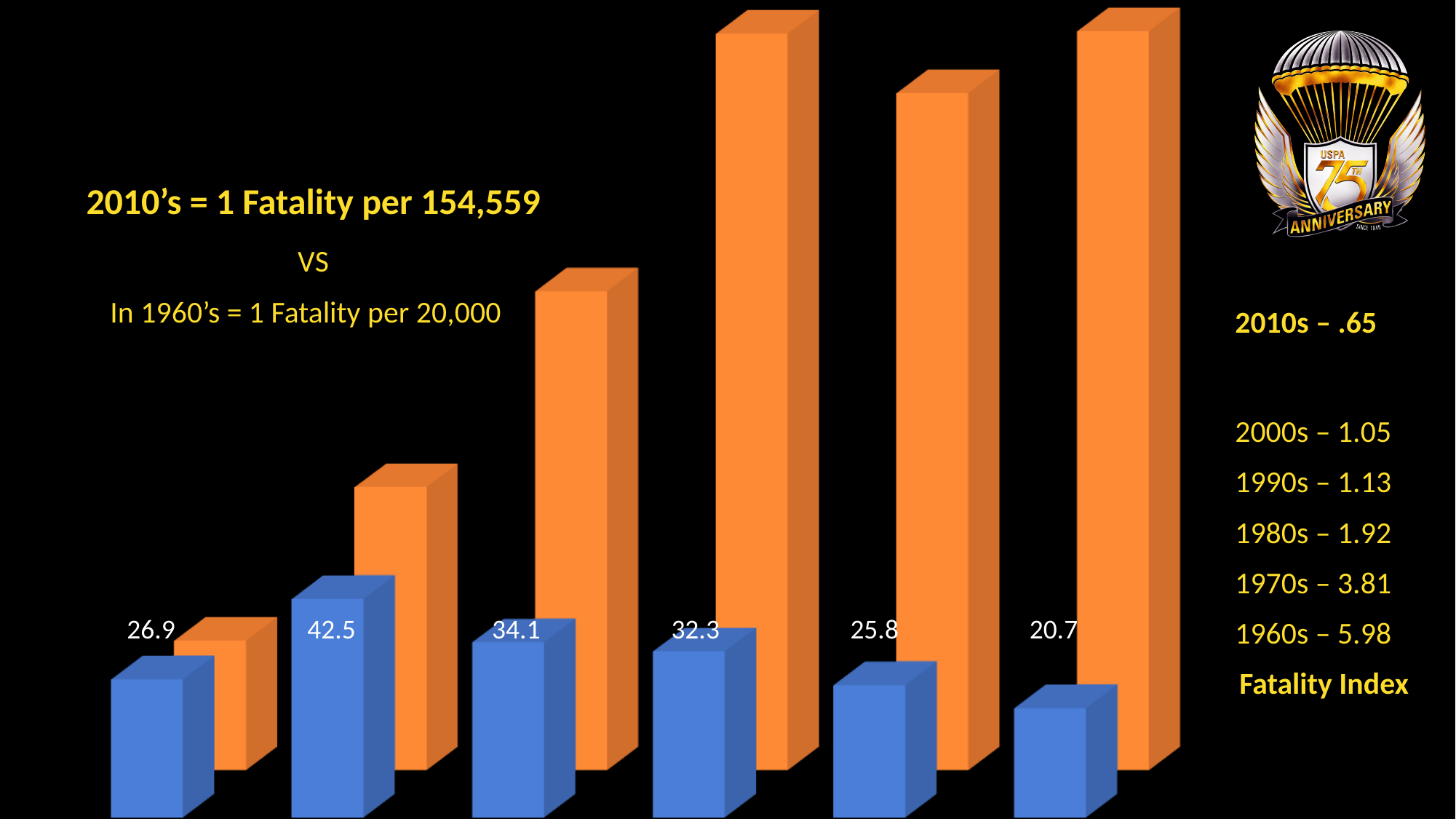
What is the value labelled on the leftmost blue bar? 26.9 What is the value labelled on the rightmost blue bar? 20.7 What is the difference between the highest blue bar value (42.5) and the lowest blue bar value (20.7)? 21.8 Do the orange bars generally rise or fall from left to right across the chart? rise Which labelled value is the highest among the blue bars? 42.5 What is the difference between the third blue bar (34.1) and the fourth blue bar (32.3)? 1.8 Which is larger, the value of the third blue bar from the left or the fourth blue bar from the left? the third blue bar (34.1) Which colour of bars carries the printed data labels in the chart? blue What kind of chart is shown on the slide? bar chart Which labelled value is the lowest among the blue bars? 20.7 How many blue bars are plotted in the chart? 6 What is the value labelled on the second blue bar from the left? 42.5